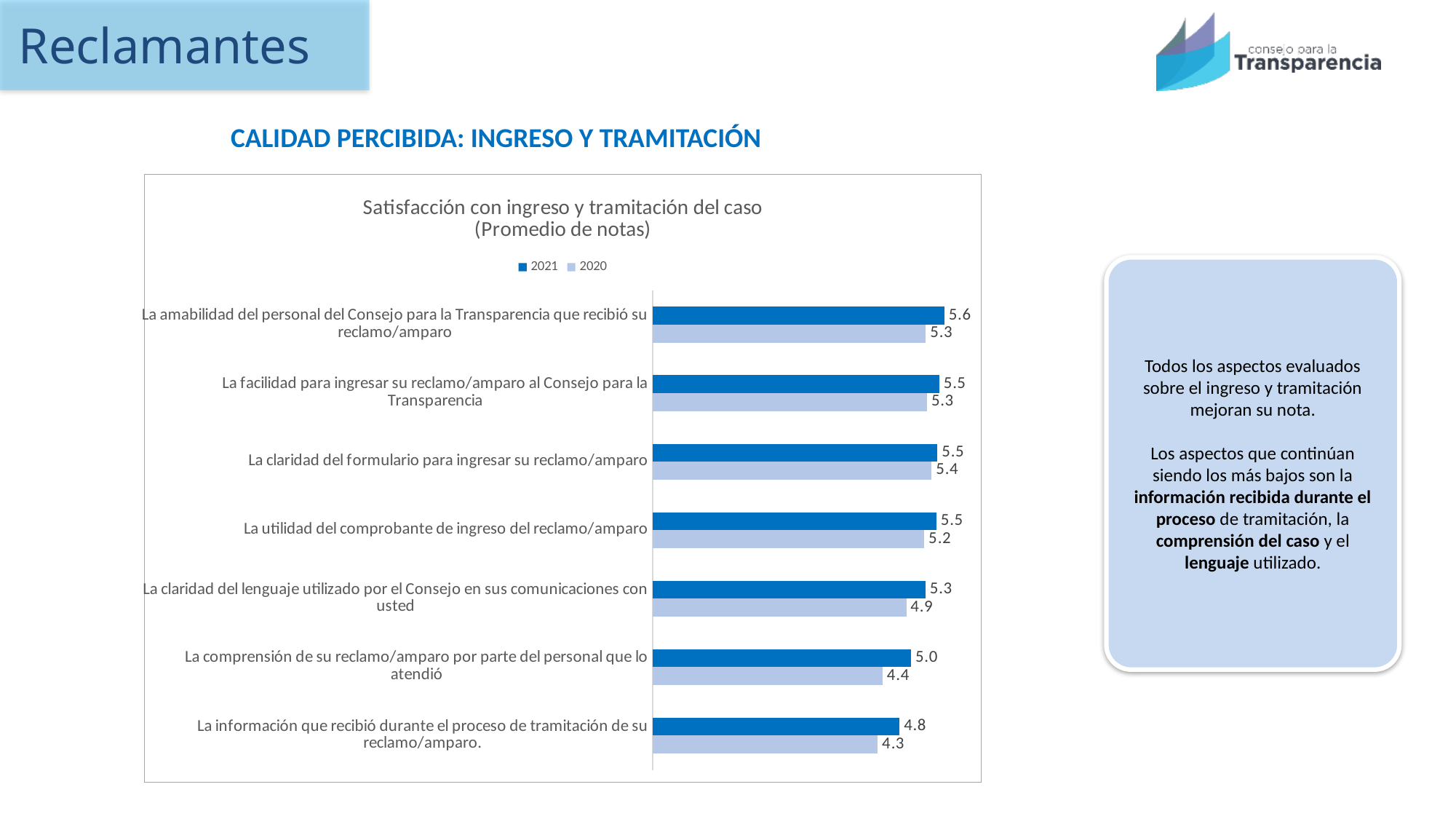
What is the difference between the 2021 and 2020 values for 'La comprensión de su reclamo/amparo por parte del personal que lo atendió'? 0.6 What is the 2021 value for 'La amabilidad del personal del Consejo para la Transparencia que recibió su reclamo/amparo'? 5.6 What is the 2020 value for 'La comprensión de su reclamo/amparo por parte del personal que lo atendió'? 4.4 Which years are listed in the chart legend? 2021 and 2020 Which category has the highest 2021 value? La amabilidad del personal del Consejo para la Transparencia que recibió su reclamo/amparo How many series does the legend list? 2 Which is larger: the 2021 value for 'La claridad del lenguaje utilizado por el Consejo en sus comunicaciones con usted' or the 2021 value for 'La comprensión de su reclamo/amparo por parte del personal que lo atendió'? La claridad del lenguaje utilizado por el Consejo en sus comunicaciones con usted What is the 2020 value for 'La información que recibió durante el proceso de tramitación de su reclamo/amparo.'? 4.3 Which category has the lowest 2020 value? La información que recibió durante el proceso de tramitación de su reclamo/amparo. What is the title of the chart? Satisfacción con ingreso y tramitación del caso (Promedio de notas) What kind of chart is shown on the slide? Bar chart How many categories are shown in the chart? 7